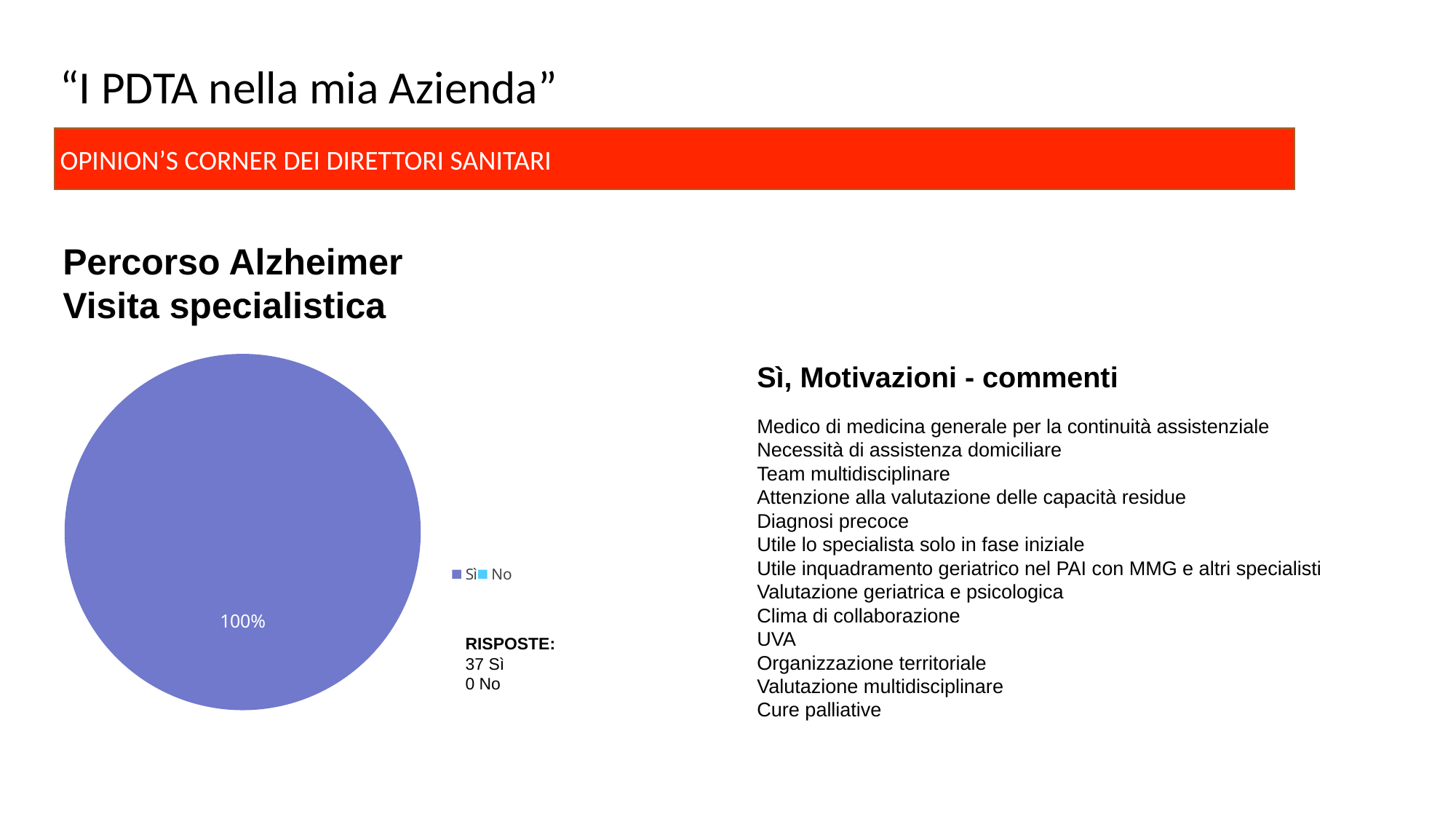
Which is larger in the pie chart, "Sì" or "No"? Sì What colour is the "Sì" slice of the pie chart? blue-purple How many entries does the legend of the pie chart list? 2 What are the two legend entries of the pie chart? Sì, No Which category has the largest slice in the pie chart? Sì What kind of chart is shown on the slide? pie chart Which category has the smallest slice in the pie chart? No Is the share for "Sì" greater or less than 50%? greater What share of the pie does the "Sì" slice represent? 100%